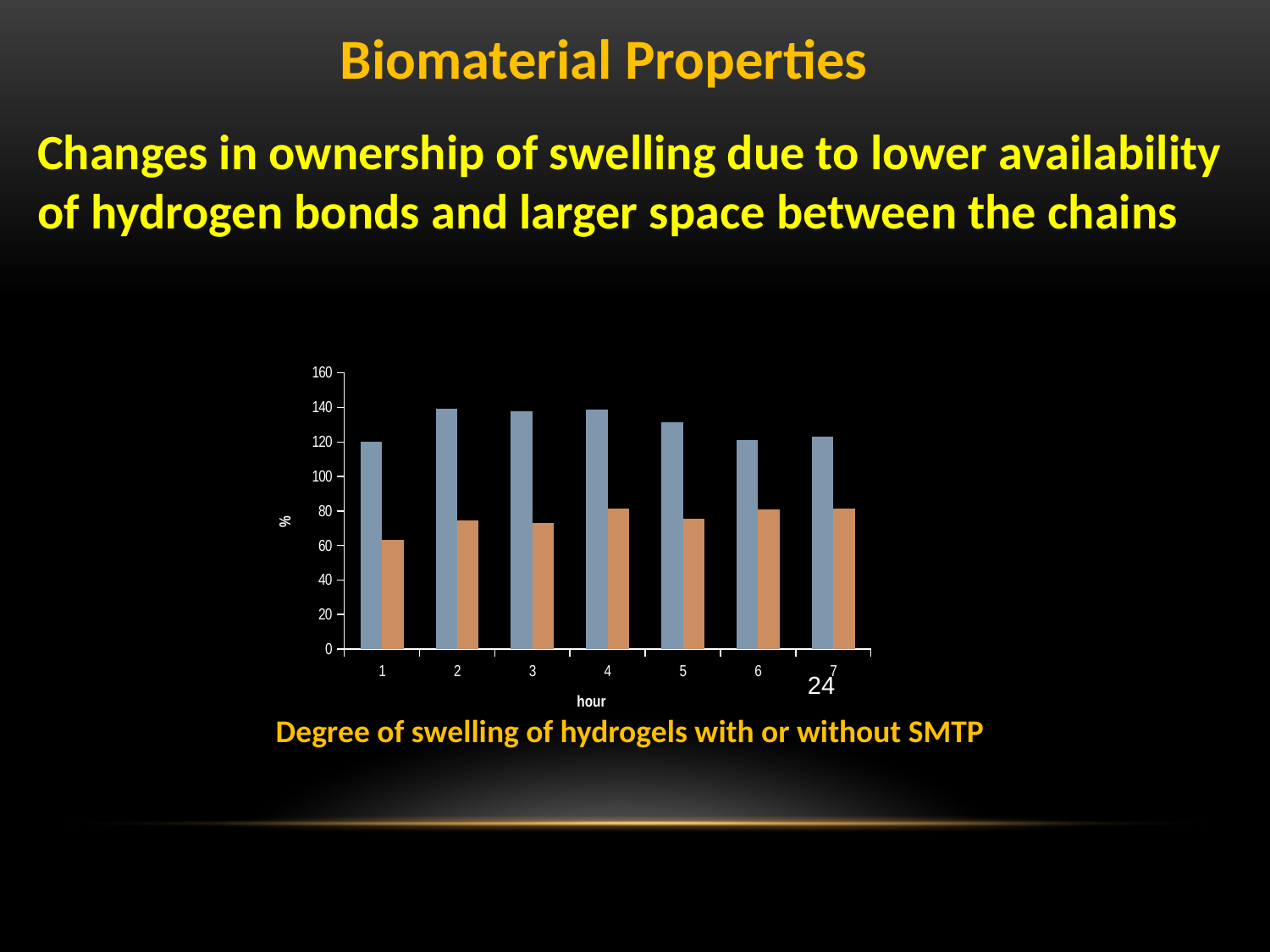
What is the label of the y axis of the chart? % What kind of chart is shown on the slide? bar chart Do the blue bars rise or fall from hour 4 to hour 6? fall Is the value of the blue bar at hour 5 greater or less than 120? greater At hour 3, which bar is taller, the blue bar or the orange bar? the blue bar How many hour categories are shown on the x axis of the chart? 7 Is the value of the orange bar at hour 4 greater or less than 100? less Is the value of the blue bar at hour 6 greater or less than 140? less What is the label of the x axis of the chart? hour At which hour is the orange bar the lowest? 1